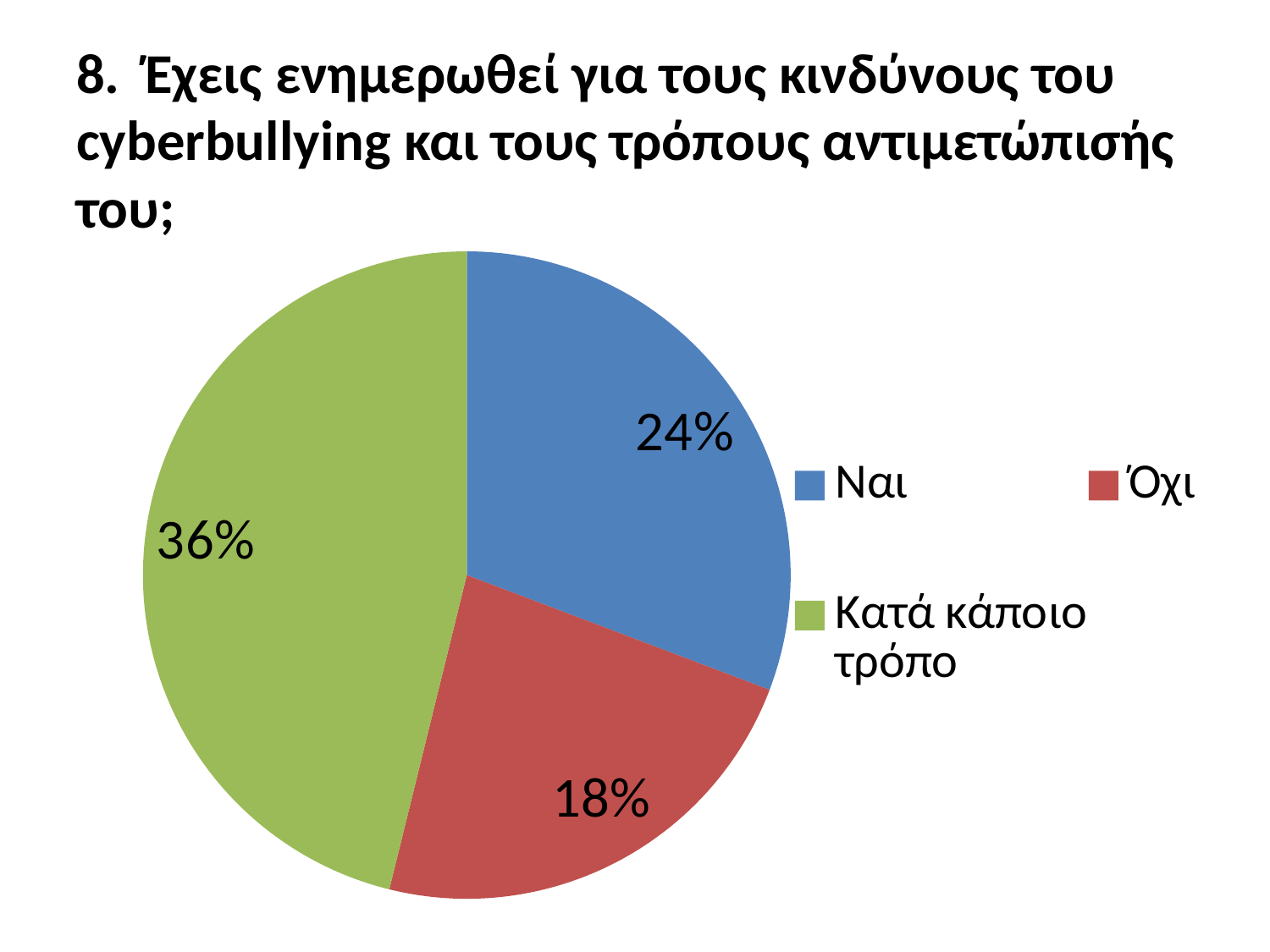
What is the difference between the values for "Ναι" and "Όχι"? 6% What colour is the "Όχι" slice? red Which category has the smallest slice of the pie? Όχι Which category has the largest slice of the pie? Κατά κάποιο τρόπο How many categories does the legend list? 3 What value is shown for the "Ναι" slice? 24% What is the difference between the values for "Κατά κάποιο τρόπο" and "Ναι"? 12% Which is larger, the value for "Ναι" or the value for "Όχι"? Ναι What kind of chart is shown on the slide? pie chart What value is shown for the "Όχι" slice? 18% What colour is the "Κατά κάποιο τρόπο" slice? green What value is shown for the "Κατά κάποιο τρόπο" slice? 36%